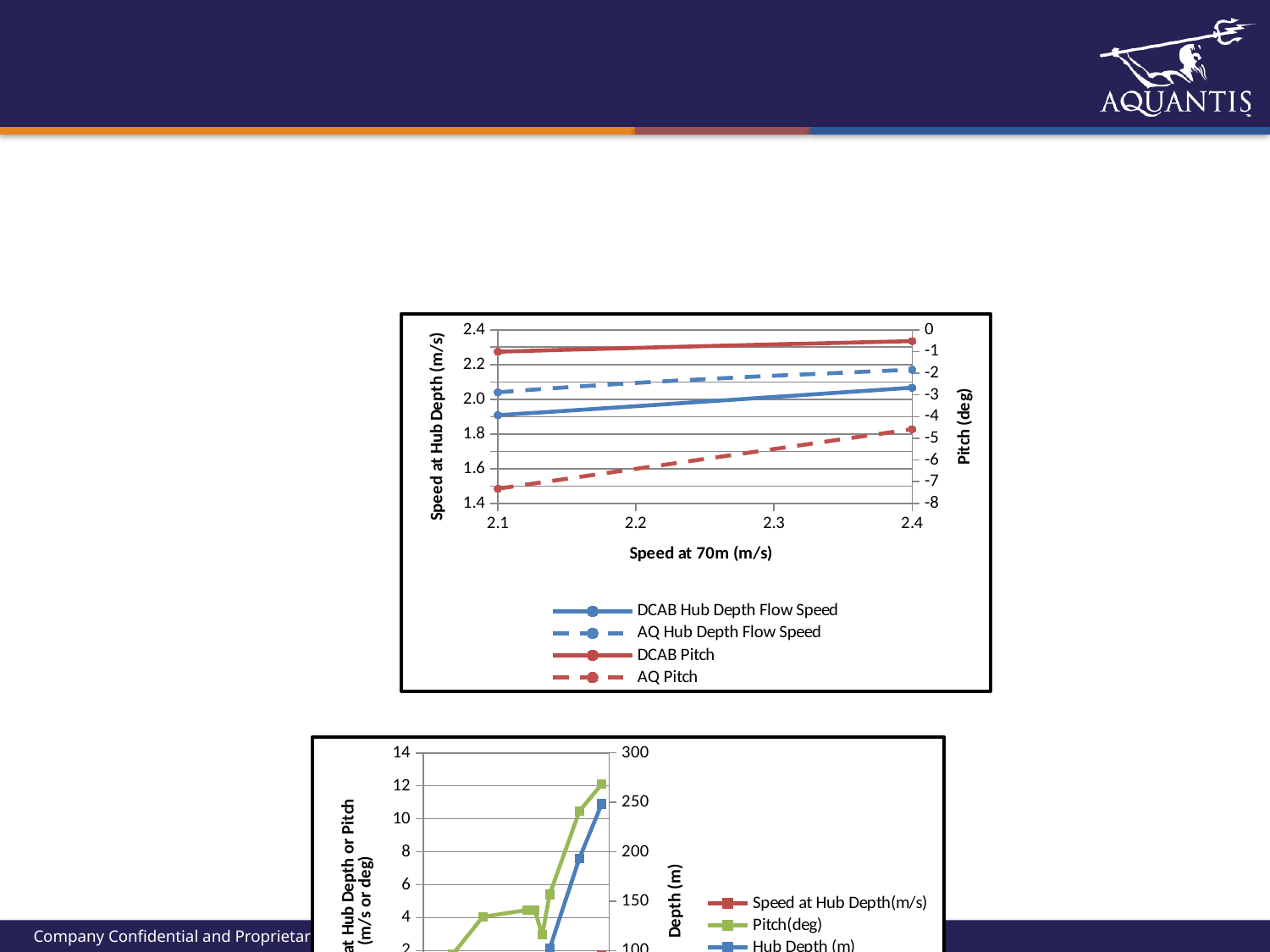
How many series does the legend of the bottom chart list? 3 In the top chart, does the AQ Pitch series rise or fall as Speed at 70m increases from 2.1 to 2.4? rise In the top chart, is the AQ Pitch value at a Speed at 70m of 2.1 greater or less than -6? less In the top chart, how many data points are plotted for the DCAB Hub Depth Flow Speed series? 2 In the top chart, is the DCAB Hub Depth Flow Speed value at a Speed at 70m of 2.1 greater or less than 2.0? less In the top chart, at a Speed at 70m of 2.4, which is larger: the AQ Hub Depth Flow Speed or the DCAB Hub Depth Flow Speed? AQ Hub Depth Flow Speed In the bottom chart, is the last plotted Hub Depth (m) value greater or less than 200? greater What kind of chart is the top chart on the slide? line chart In the top chart, what is the label of the x axis? Speed at 70m (m/s) How many series does the legend of the top chart list? 4 In the top chart, what is the label of the right-hand y axis? Pitch (deg)